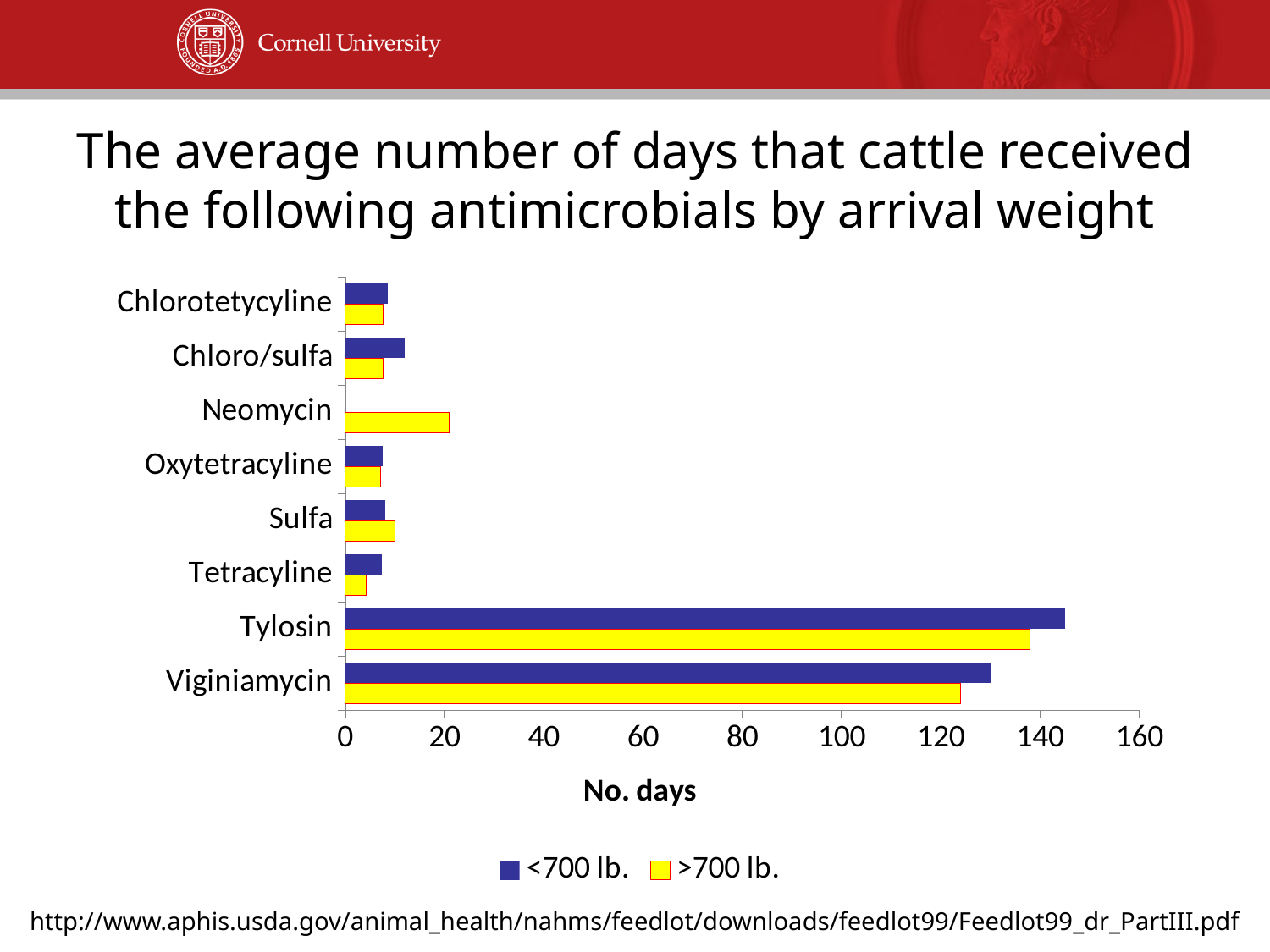
Which antimicrobial has the highest average number of days for the <700 lb. series? Tylosin Is the value for Neomycin in the >700 lb. series greater or less than 40? less How many series does the legend list? 2 How many antimicrobial categories are plotted on the chart? 8 For Chloro/sulfa, which series has the larger value: <700 lb. or >700 lb.? <700 lb. Which antimicrobial has the lowest value for the >700 lb. series? Tetracyline Which antimicrobial has the highest average number of days for the >700 lb. series? Tylosin What is the title of the horizontal axis? No. days What kind of chart is shown on the slide? bar chart For the <700 lb. series, which is larger: Tylosin or Viginiamycin? Tylosin Is the value for Tylosin in the <700 lb. series greater or less than 140? greater Is the value for Viginiamycin in the >700 lb. series greater or less than 120? greater